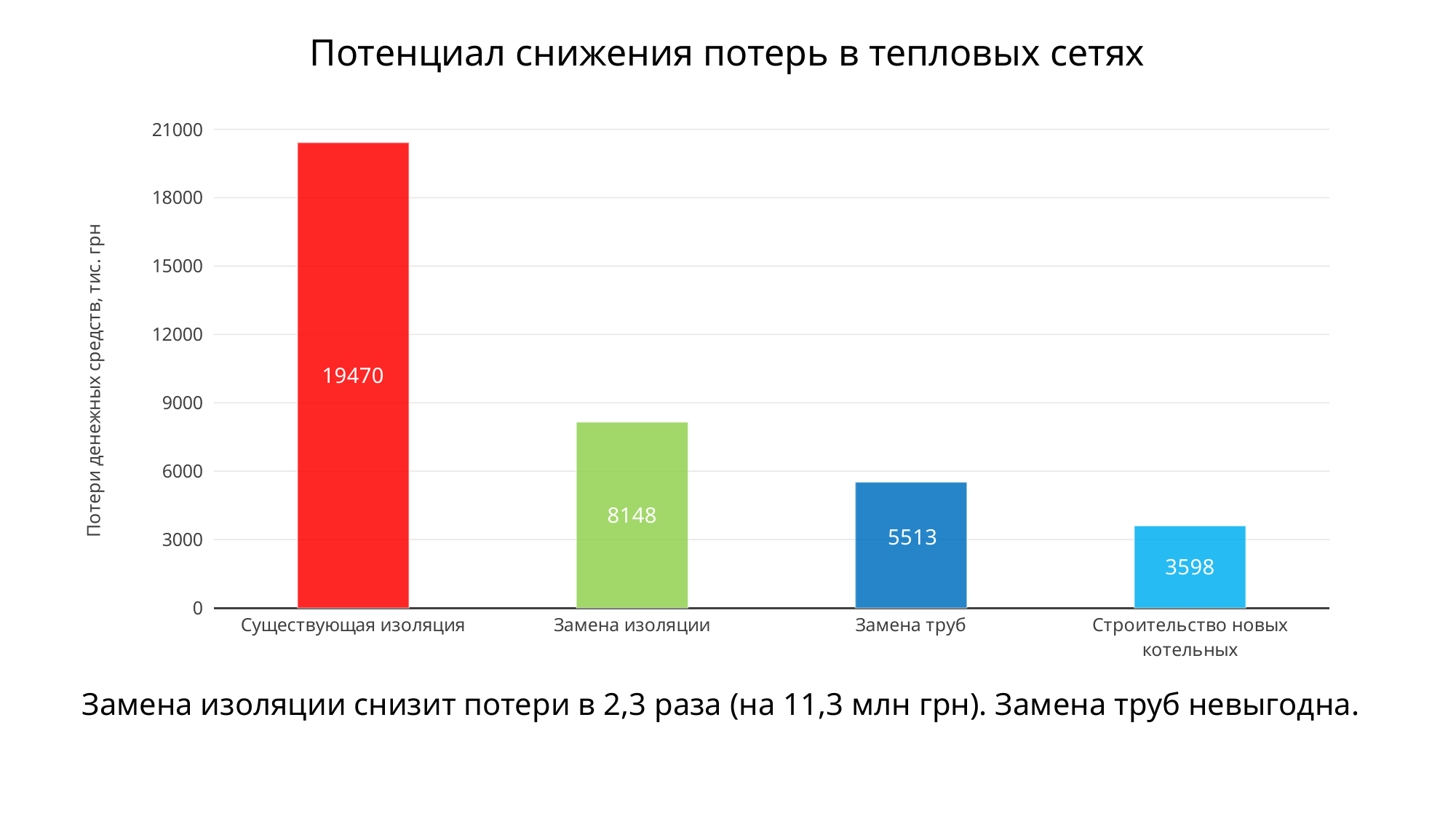
What is the value for Замена труб? 5513 What is the difference between the values for Замена труб and Строительство новых котельных? 1915 What is the value for Замена изоляции? 8148 What is the value for Существующая изоляция? 19470 What is the title of the chart? Потенциал снижения потерь в тепловых сетях Which category has the highest value? Существующая изоляция How many categories are shown on the chart? 4 What is the difference between the values for Существующая изоляция and Замена изоляции? 11322 Which is larger, the value for Замена изоляции or the value for Замена труб? Замена изоляции What is the value for Строительство новых котельных? 3598 Which category has the lowest value? Строительство новых котельных What kind of chart is shown on the slide? bar chart